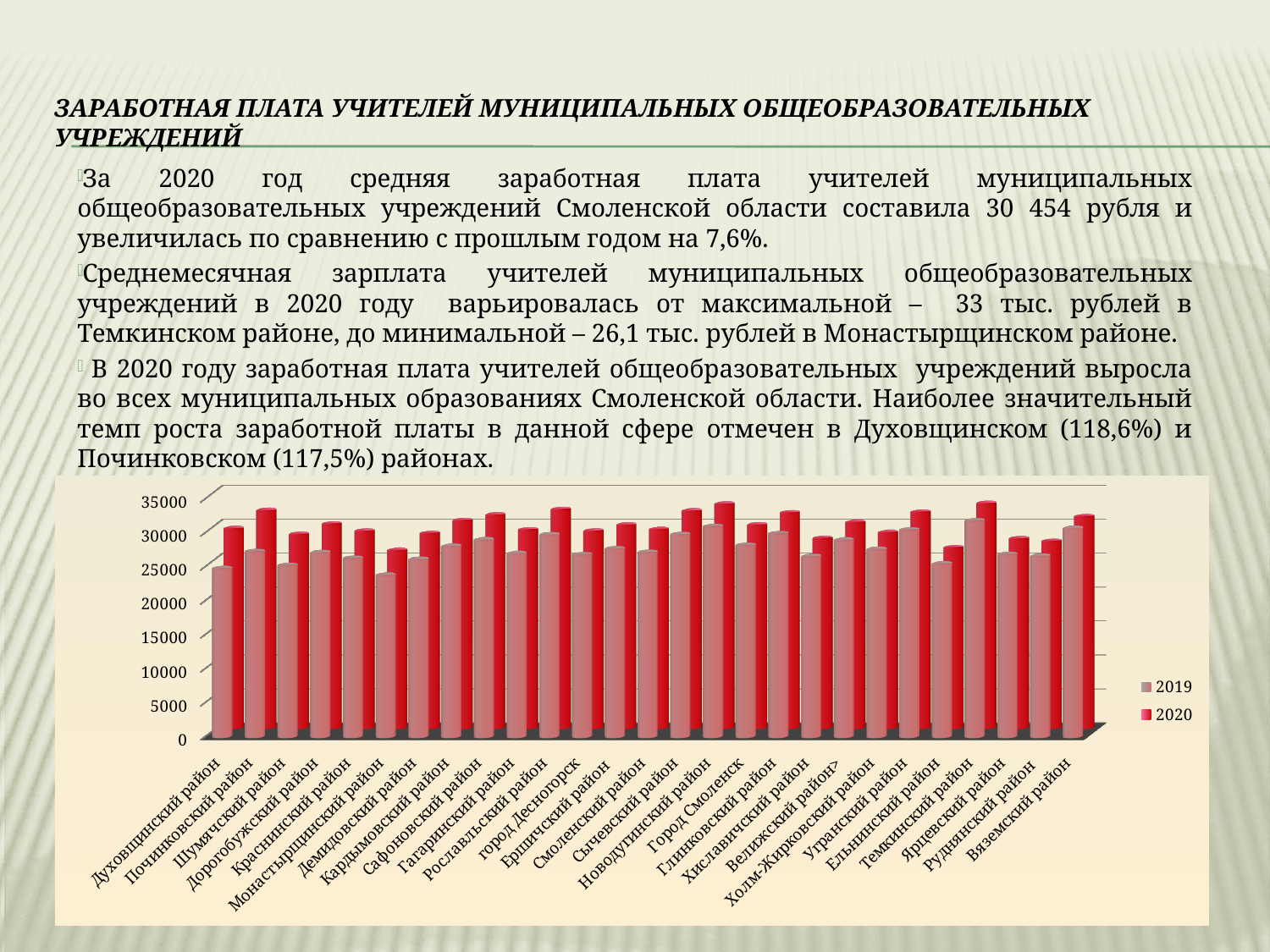
What are the two series named in the chart legend? 2019 and 2020 Which is larger: the 2020 value for Темкинский район or the 2020 value for Монастырщинский район? Темкинский район For Духовщинский район, which series has the larger value, 2019 or 2020? 2020 Which district has the lowest 2020 value in the chart? Монастырщинский район What kind of chart is shown on the slide? bar chart Is the 2020 value for Ельнинский район greater or less than 30000? less Is the 2019 value for Монастырщинский район greater or less than 25000? less How many series does the chart legend list? 2 Which district has the highest 2020 value in the chart? Темкинский район How many districts (categories) are shown on the x axis of the chart? 27 Is the 2020 value for Темкинский район greater or less than 30000? greater